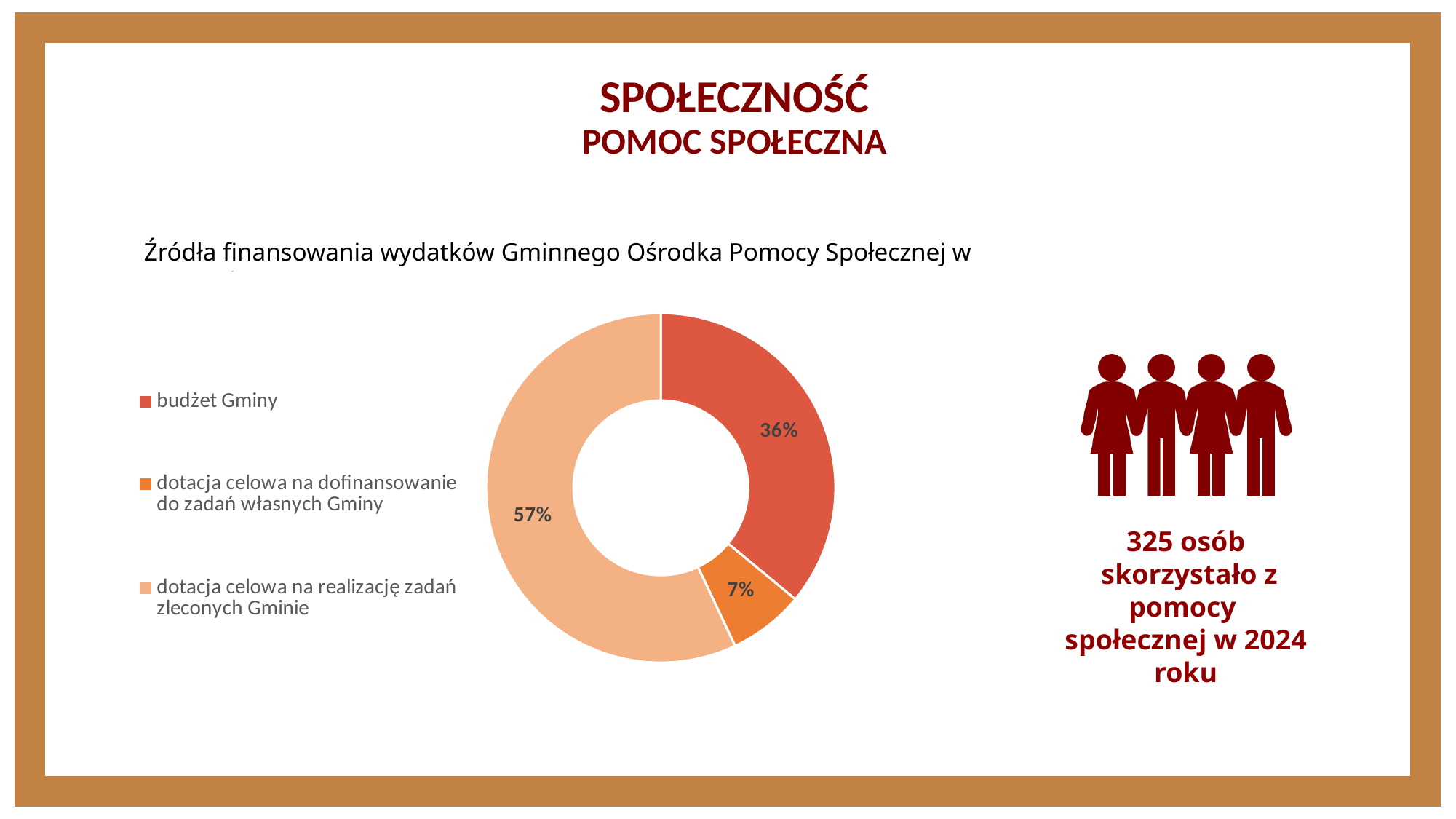
What colour is the slice for 'budżet Gminy'? red Which category has the smallest share in the doughnut chart? dotacja celowa na dofinansowanie do zadań własnych Gminy How many entries does the chart legend list? 3 What is the difference in percentage points between the share for 'dotacja celowa na realizację zadań zleconych Gminie' and the share for 'budżet Gminy'? 21 percentage points How many categories are shown in the doughnut chart? 3 Which is larger: the share for 'budżet Gminy' or the share for 'dotacja celowa na dofinansowanie do zadań własnych Gminy'? budżet Gminy What kind of chart is shown on the slide? doughnut (pie) chart What is the difference in percentage points between the share for 'budżet Gminy' and the share for 'dotacja celowa na dofinansowanie do zadań własnych Gminy'? 29 percentage points What share of the doughnut chart does 'budżet Gminy' represent? 36% Which category has the largest share in the doughnut chart? dotacja celowa na realizację zadań zleconych Gminie What share of the doughnut chart does 'dotacja celowa na dofinansowanie do zadań własnych Gminy' represent? 7% What share of the doughnut chart does 'dotacja celowa na realizację zadań zleconych Gminie' represent? 57%